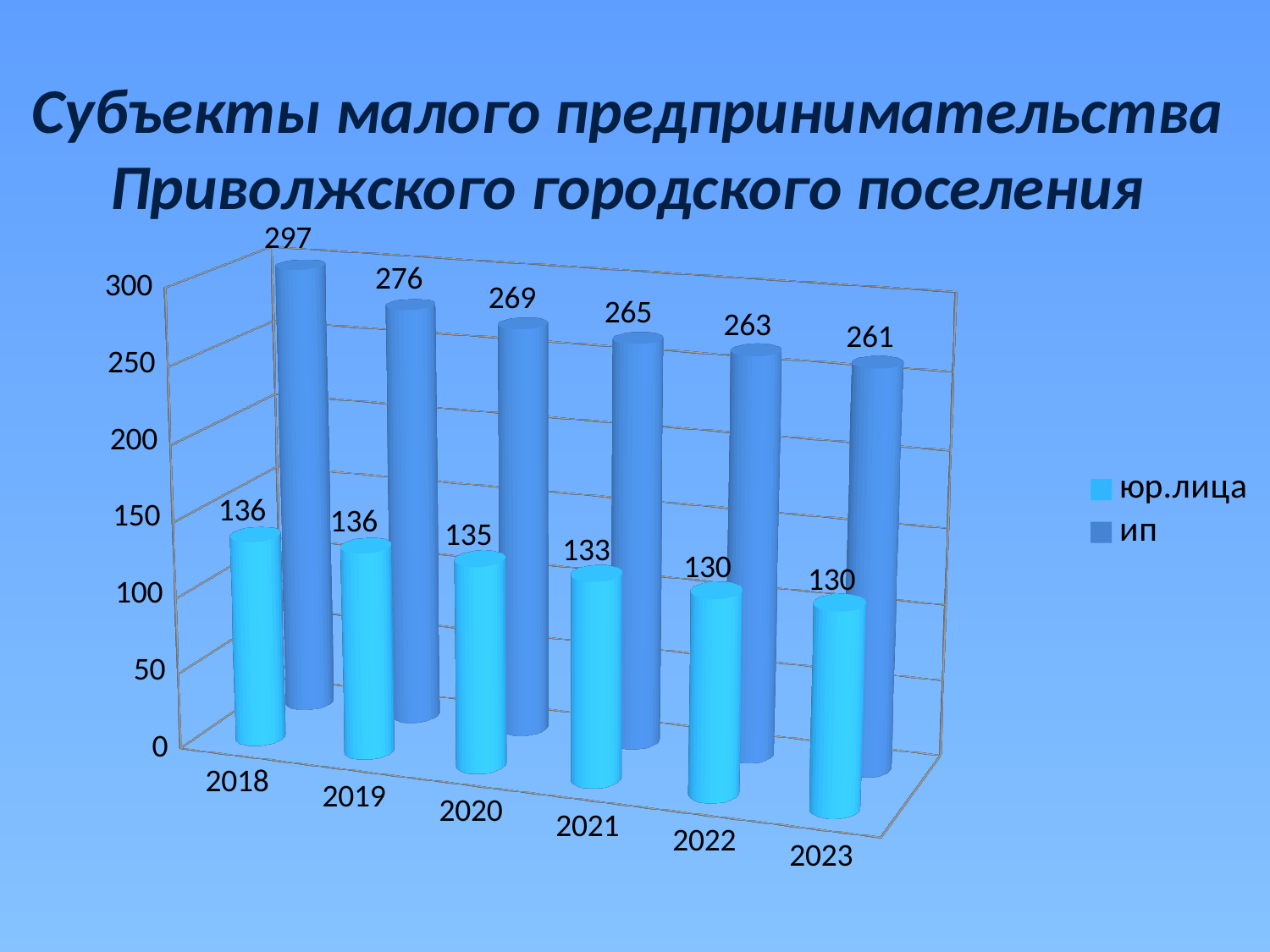
What is the difference between the юр.лица values for 2018 and 2023? 6 How many years are shown on the x axis? 6 Do the ип values rise or fall from 2018 to 2023? fall What kind of chart is shown on the slide? bar chart What is the value for юр.лица in 2021? 133 In which year is the ип value lowest? 2023 What is the value for ип in 2018? 297 What is the value for ип in 2023? 261 In which year is the ип value highest? 2018 What is the difference between the ип values for 2018 and 2019? 21 Which is larger in 2020: the value for ип or the value for юр.лица? ип How many series does the legend list? 2